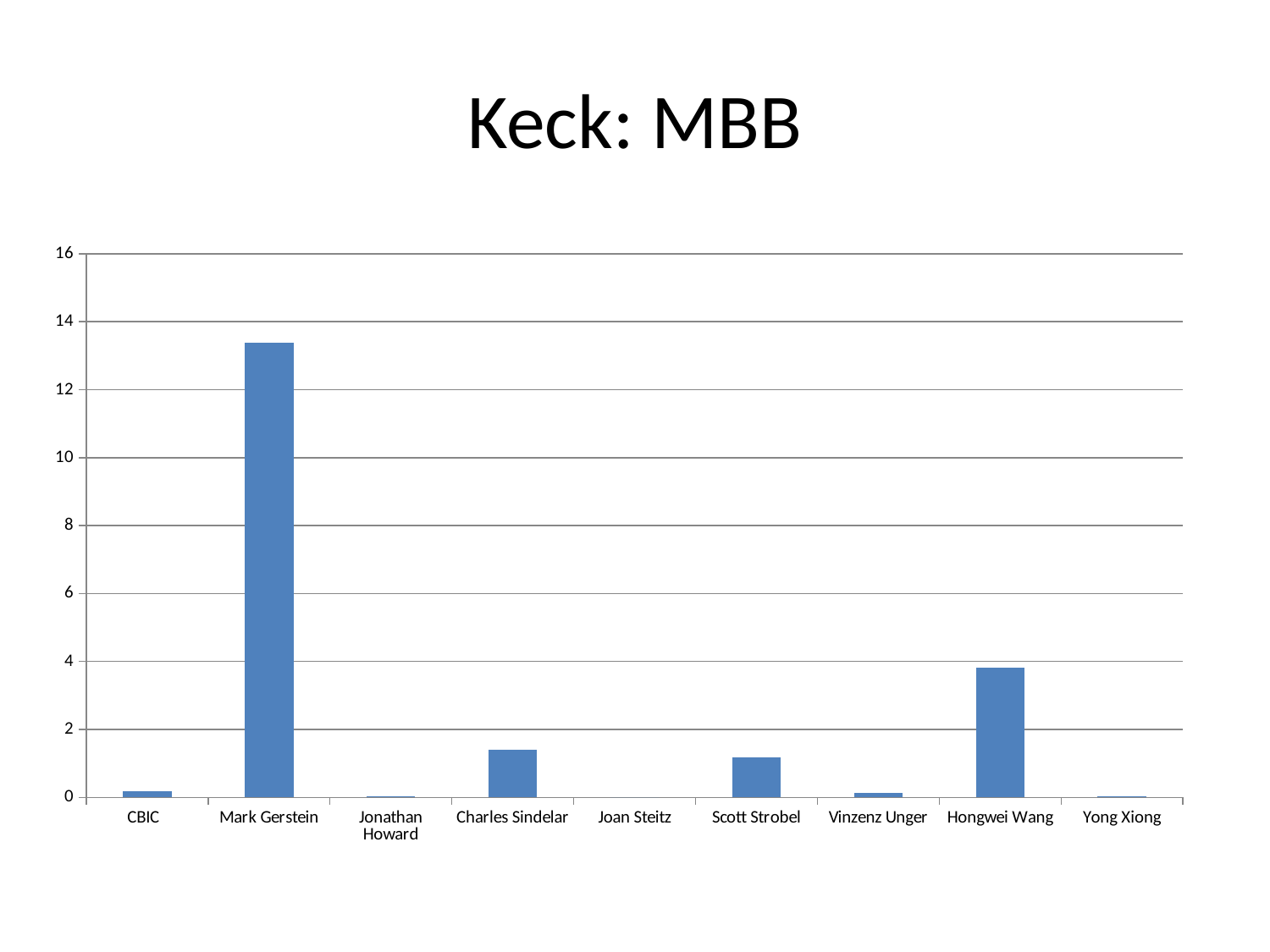
What is the title of the chart on the slide? Keck: MBB Is the value for Scott Strobel greater or less than 2? less Is the value for Hongwei Wang greater or less than 2? greater Which is larger, the value for Mark Gerstein or the value for Hongwei Wang? Mark Gerstein How many categories are shown on the x axis of the chart? 9 Is the value for Charles Sindelar greater or less than 2? less Which category has the highest value in the chart? Mark Gerstein What kind of chart is shown on the slide? bar chart Which is larger, the value for Hongwei Wang or the value for Charles Sindelar? Hongwei Wang